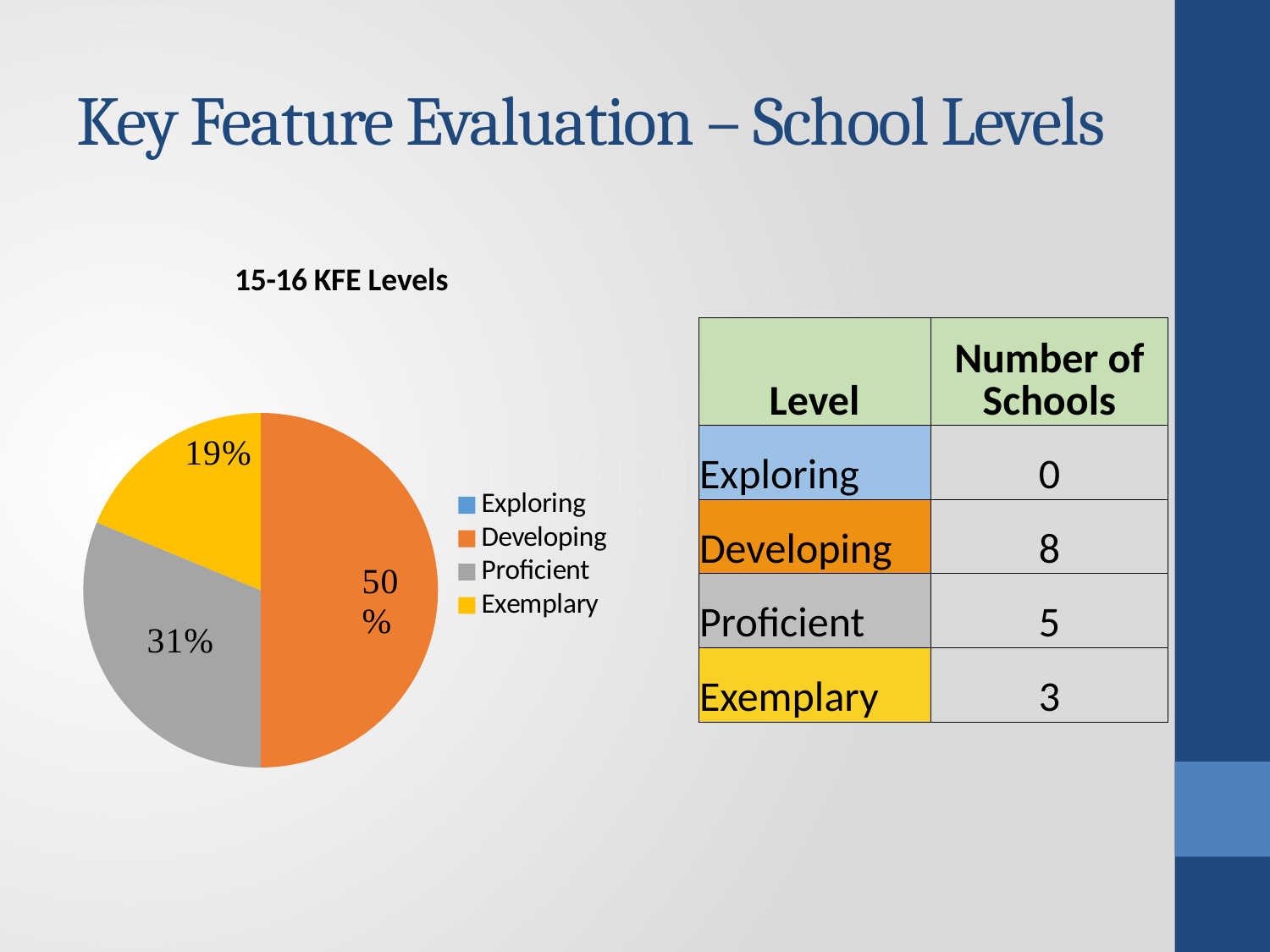
How many entries does the pie chart's legend list? 4 Which category has the largest slice of the pie? Developing Of the slices with a printed percentage, which category has the smallest slice? Exemplary What is the title of the pie chart? 15-16 KFE Levels What is the difference in percentage points between the Proficient and Exemplary slices? 12 What colour is the Exemplary slice in the pie chart? yellow What share of the pie does Proficient take? 31% What is the difference in percentage points between the Developing and Proficient slices? 19 Which slice is larger, Proficient or Exemplary? Proficient What share of the pie does Developing take? 50% What kind of chart is shown on the slide? pie chart What share of the pie does Exemplary take? 19%